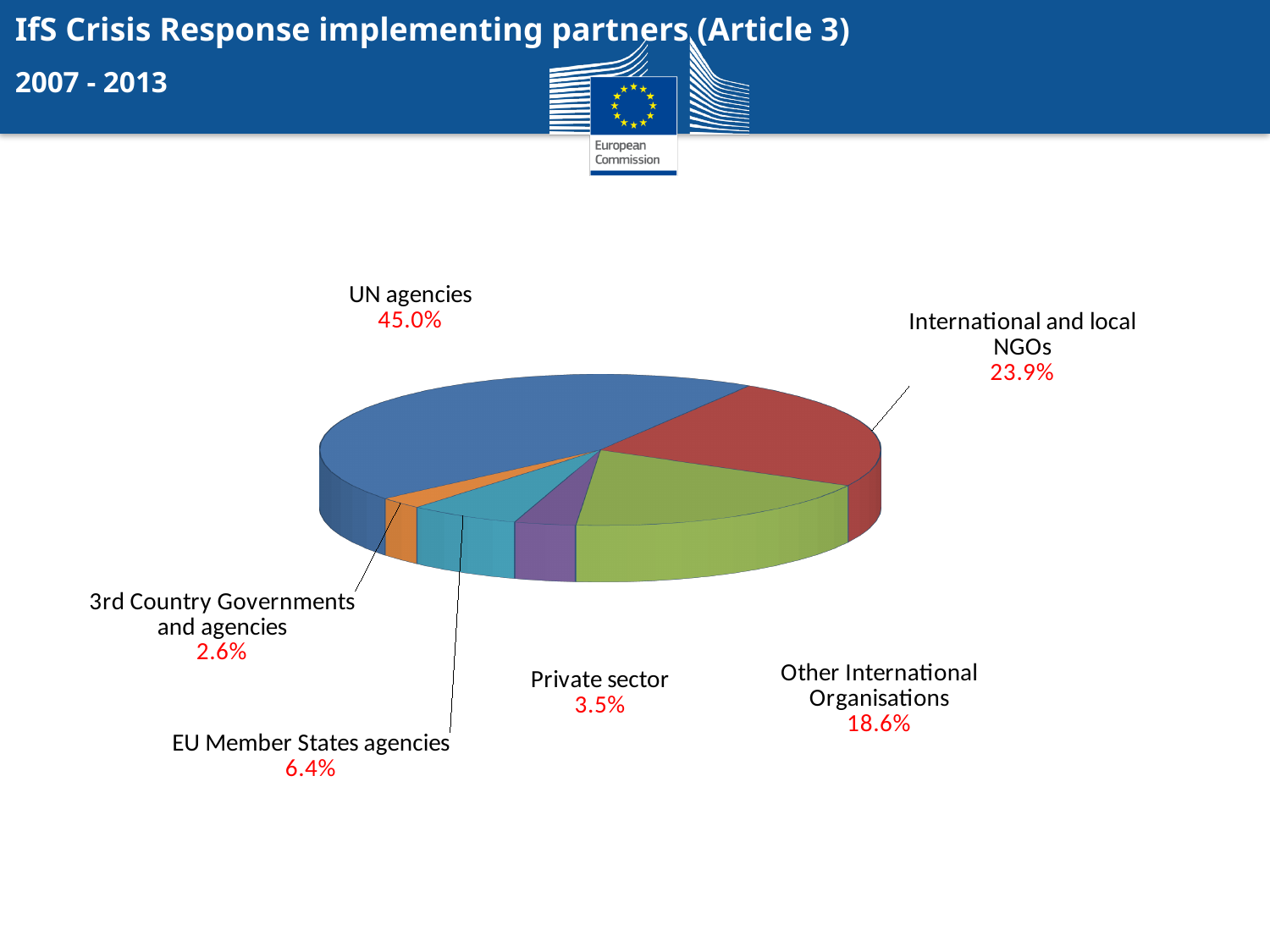
Which category has the largest share of the pie? UN agencies Which is larger, the share for EU Member States agencies or the share for Private sector? EU Member States agencies What kind of chart is shown on the slide? Pie chart What percentage is shown for International and local NGOs? 23.9% What is the value for the Private sector slice? 3.5% What is the value for Other International Organisations? 18.6% What percentage is shown for EU Member States agencies? 6.4% What period does the chart title say the data covers? 2007 - 2013 Which category has the smallest share of the pie? 3rd Country Governments and agencies What share of the pie do UN agencies account for? 45.0% How many categories are shown in the pie chart? 6 What is the difference in percentage points between UN agencies and International and local NGOs? 21.1